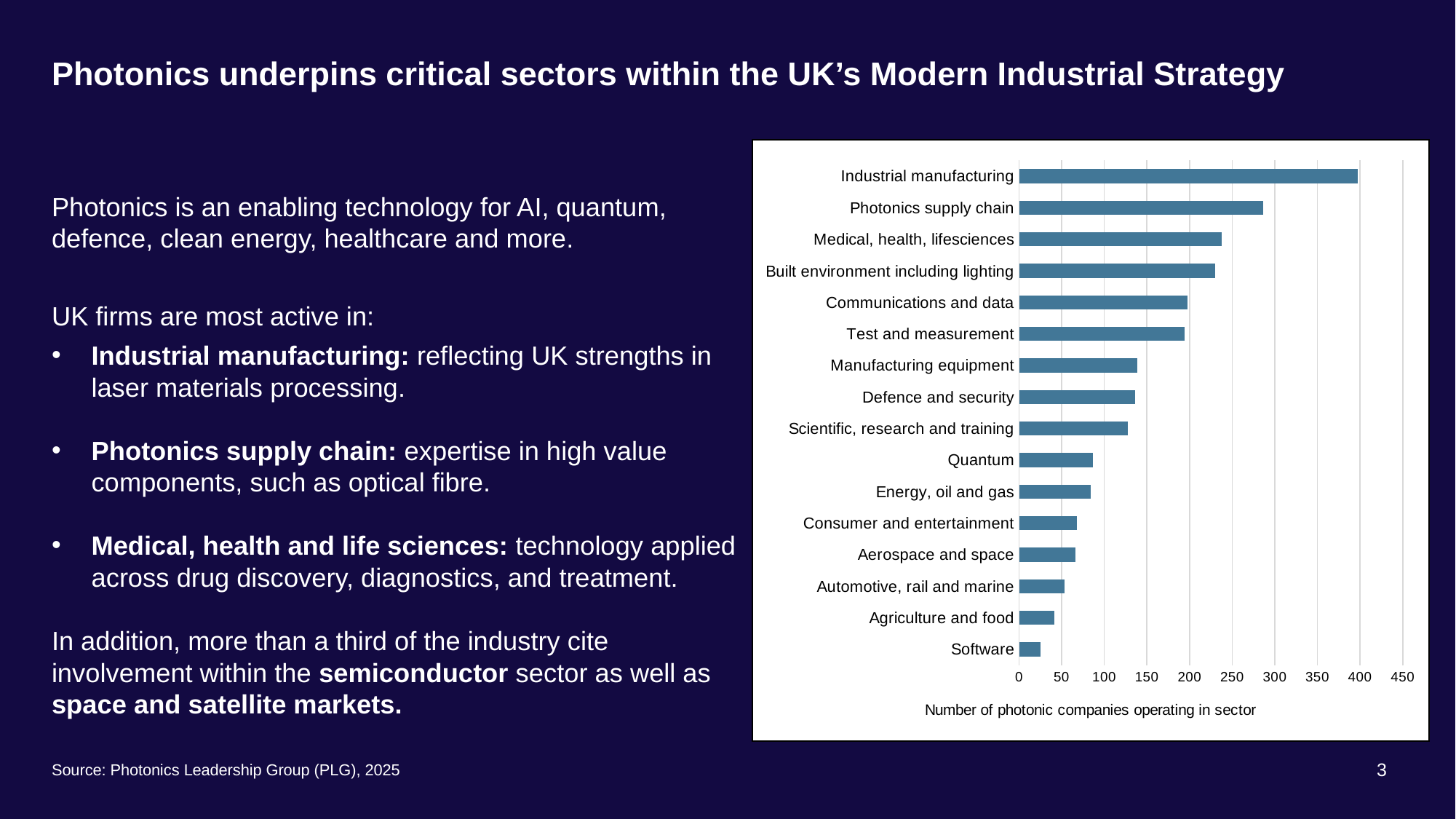
Is the value for Quantum greater or less than 100? less What kind of chart is shown on the slide? bar chart Which sector has the highest number of photonic companies operating in it? Industrial manufacturing Which has more photonic companies: Agriculture and food or Scientific, research and training? Scientific, research and training Which has more photonic companies: Defence and security or Aerospace and space? Defence and security Is the value for Software greater or less than 50? less Is the value for Photonics supply chain greater or less than 300? less Which sector has the lowest number of photonic companies operating in it? Software What is the label on the horizontal axis of the chart? Number of photonic companies operating in sector How many sectors are plotted in the chart? 16